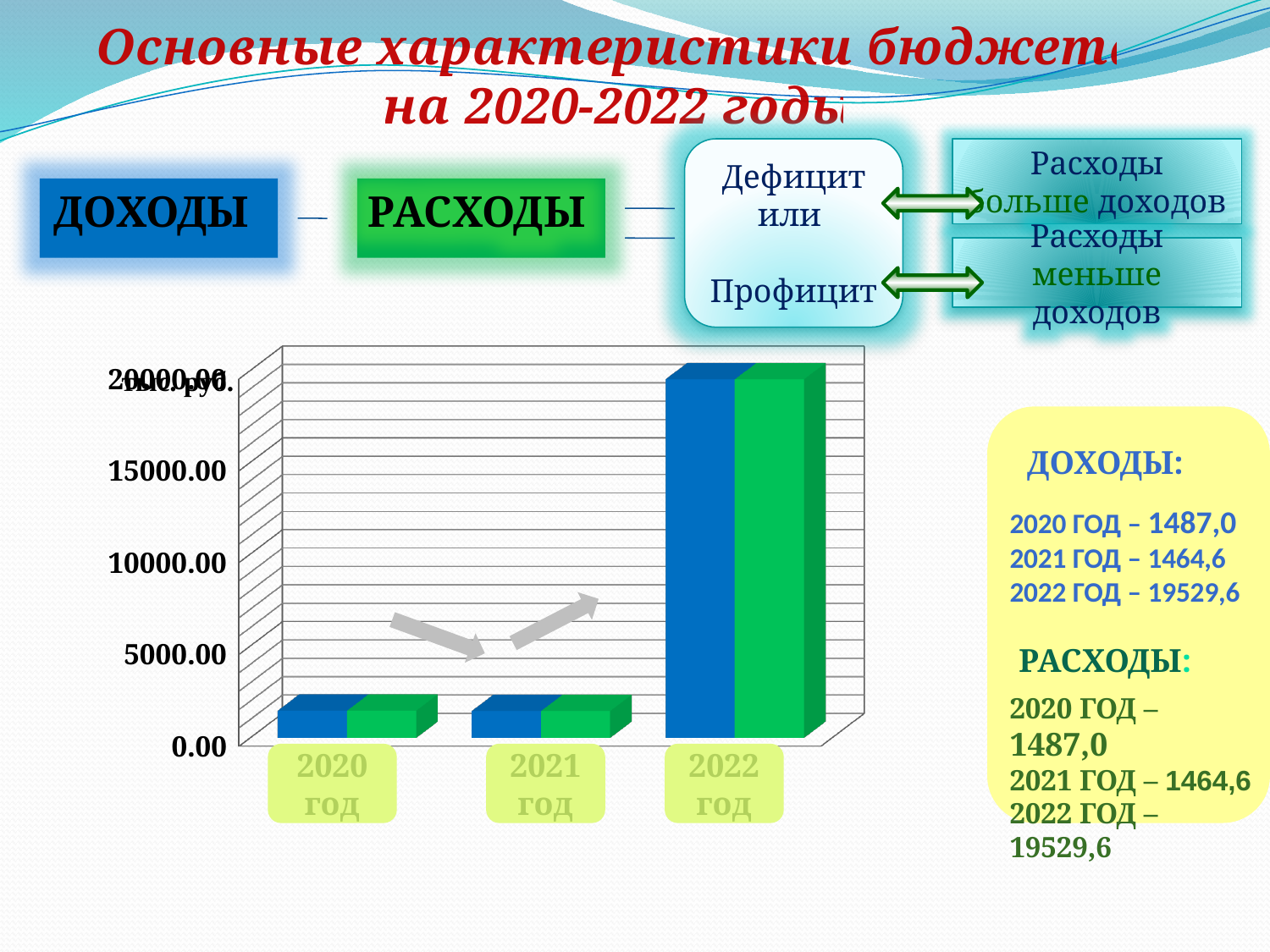
How many bars are plotted for each year category in the chart? 2 Which year has the highest bars in the chart? 2022 год How many year categories are shown on the x axis of the chart? 3 Do the bar values rise or fall from 2021 год to 2022 год? rise Which is larger in the chart, the value for 2022 год or the value for 2020 год? 2022 год According to the slide, what is the value of ДОХОДЫ for 2022 год? 19529,6 Is the value for 2022 год greater or less than 15000.00? greater According to the slide, what is the value of РАСХОДЫ for 2021 год? 1464,6 Is the value for 2020 год greater or less than 5000.00? less What unit is shown on the vertical axis of the chart? тыс.руб. What kind of chart is shown on the slide? bar chart Is the value for 2021 год greater or less than 5000.00? less